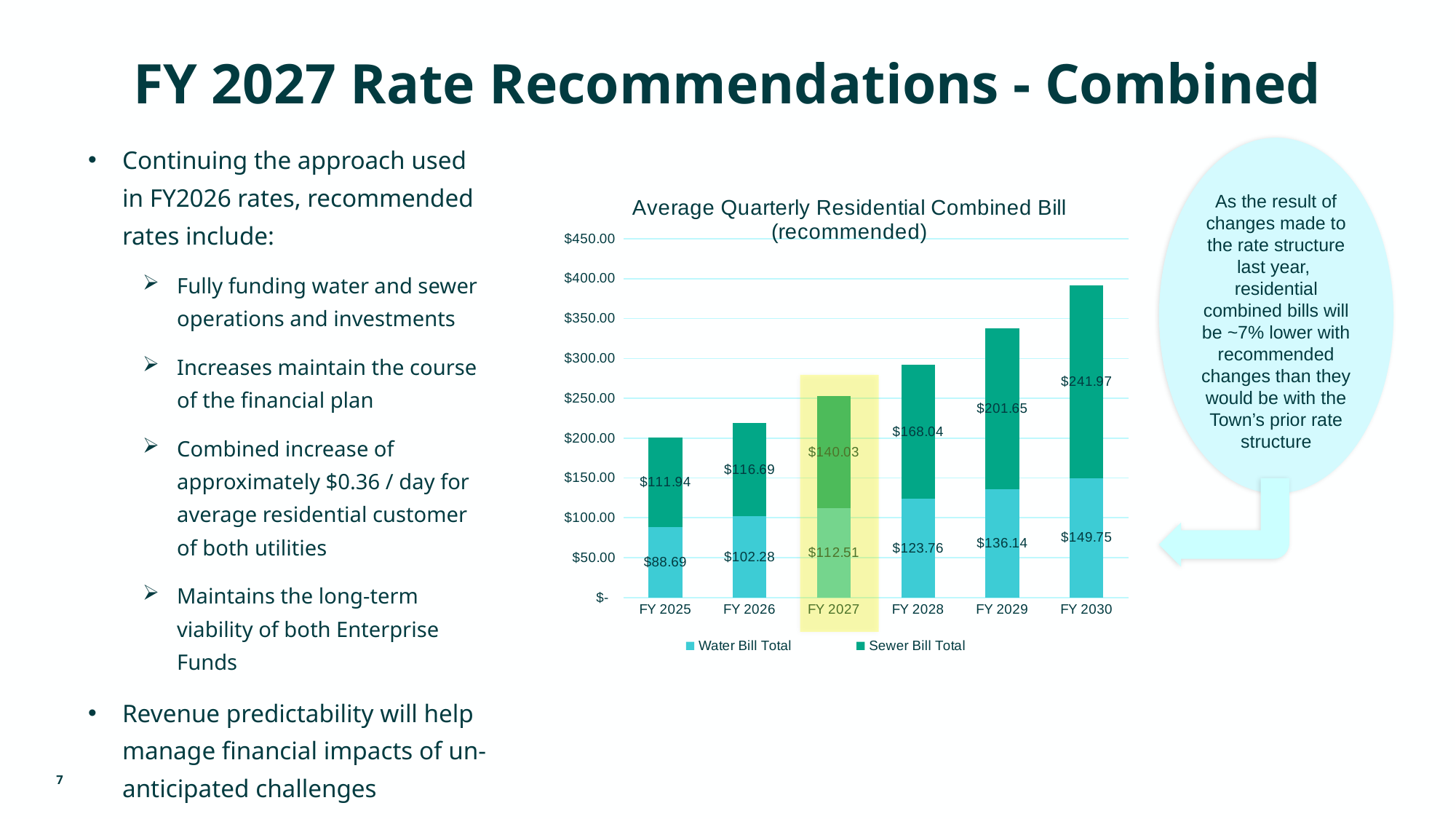
What is the Sewer Bill Total for FY 2030? $241.97 What is the total combined bill (Water plus Sewer) for FY 2027? $252.54 Which fiscal year has the highest Sewer Bill Total? FY 2030 What kind of chart is shown on the slide? Stacked bar chart Which is larger in FY 2029, the Water Bill Total or the Sewer Bill Total? Sewer Bill Total What is the Sewer Bill Total for FY 2025? $111.94 How many series does the chart legend list? 2 How many fiscal years are shown on the x axis of the chart? 6 What is the Water Bill Total for FY 2027? $112.51 Which fiscal year has the lowest Water Bill Total? FY 2025 What is the difference between the Sewer Bill Total for FY 2028 and FY 2027? $28.01 What is the total combined bill (Water plus Sewer) for FY 2030? $391.72